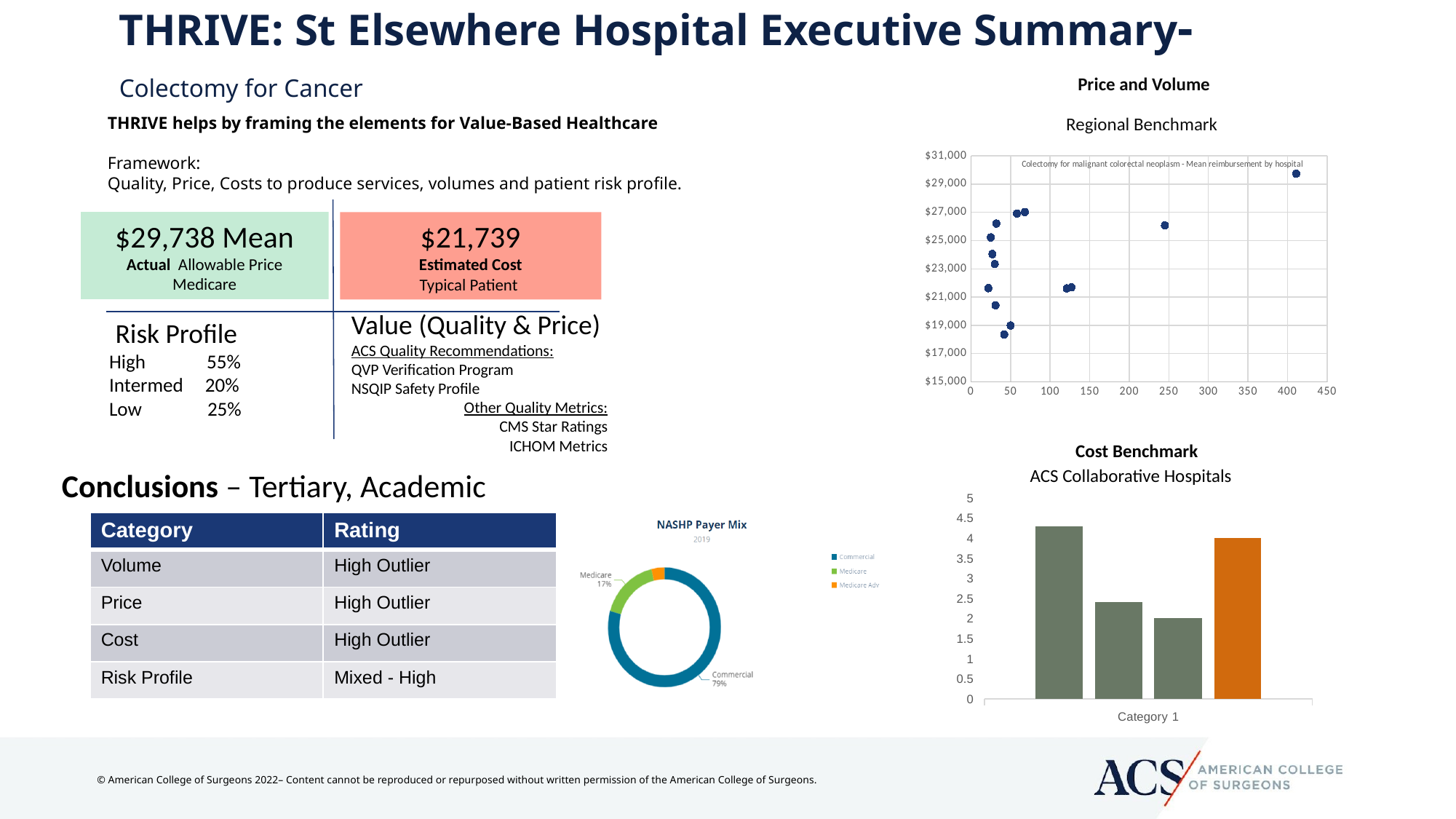
In the Regional Benchmark scatter chart, is the value of the highest point greater or less than $29,000? greater What kind of chart is the Regional Benchmark chart under Price and Volume? scatter chart In the NASHP Payer Mix chart, what share does Commercial have? 79% In the NASHP Payer Mix chart, what share does Medicare have? 17% How many bars are plotted in the Cost Benchmark bar chart? 4 What kind of chart is the Cost Benchmark chart for ACS Collaborative Hospitals? bar chart How many entries does the legend of the NASHP Payer Mix chart list? 3 In the NASHP Payer Mix chart, which payer has the largest slice? Commercial In the Regional Benchmark scatter chart, is the value of the lowest point greater or less than $19,000? less What kind of chart is the NASHP Payer Mix chart? donut chart In the Cost Benchmark bar chart, is the value of the first (leftmost) bar greater or less than 4? greater What is the highest tick shown on the x axis of the Regional Benchmark scatter chart? 450